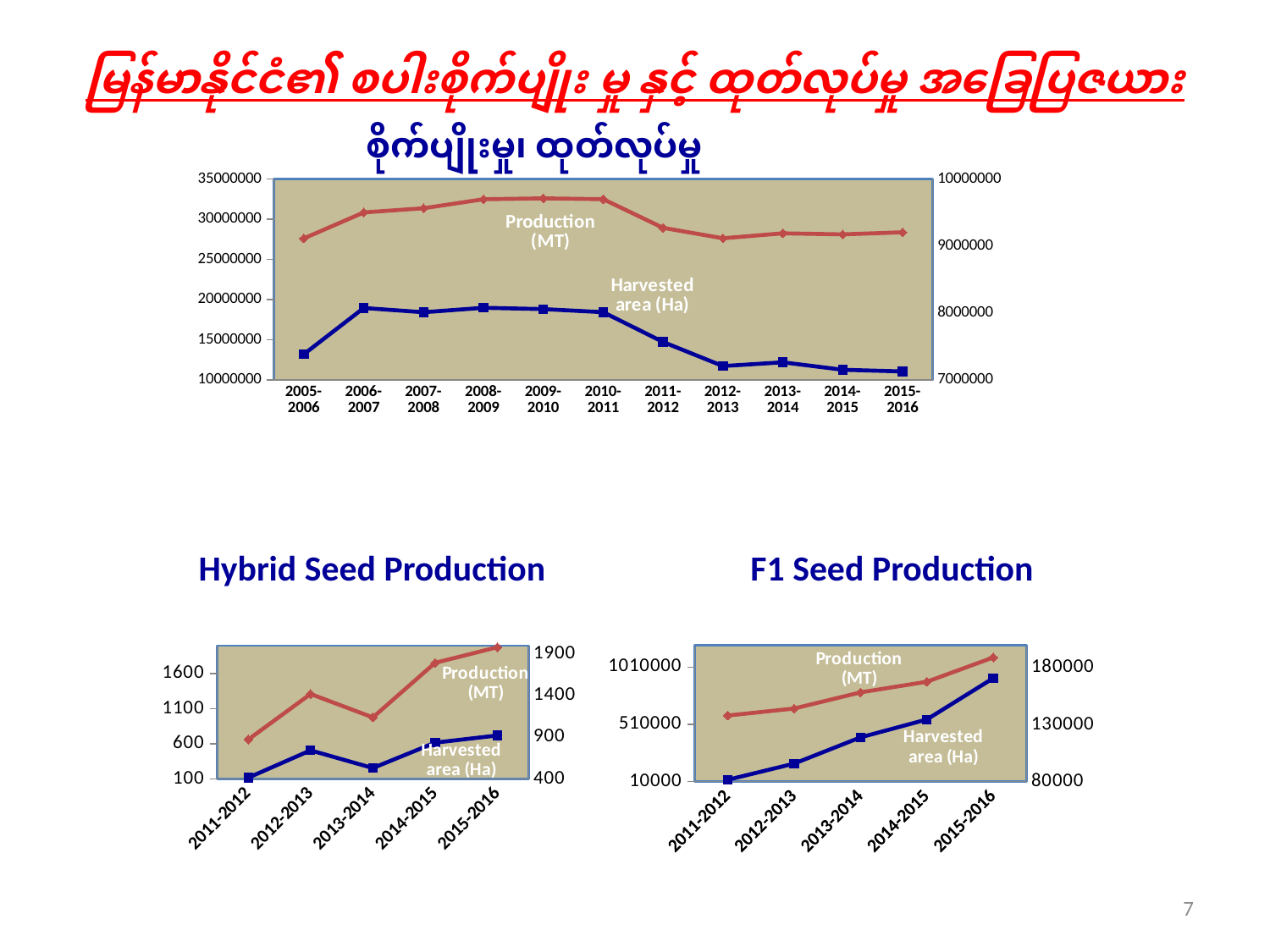
In the top chart, which is larger for Harvested area (Ha): 2010-2011 or 2012-2013? 2010-2011 In the top chart, is the Harvested area (Ha) value for 2005-2006 greater or less than 15000000? less In the top chart, is the Production (MT) value for 2009-2010 greater or less than 9000000? greater How many series does the top chart plot? 2 How many year categories are shown in the 'F1 Seed Production' chart? 5 In the 'F1 Seed Production' chart, is the Harvested area (Ha) value for 2015-2016 greater or less than 510000? less How many year categories are shown on the x axis of the top chart? 11 In the 'Hybrid Seed Production' chart, which year has the highest Production (MT)? 2015-2016 In the 'F1 Seed Production' chart, does the Harvested area (Ha) rise or fall from 2011-2012 to 2015-2016? rise What type of chart is the 'Hybrid Seed Production' chart? line chart In the 'Hybrid Seed Production' chart, which year has the lowest Harvested area (Ha)? 2011-2012